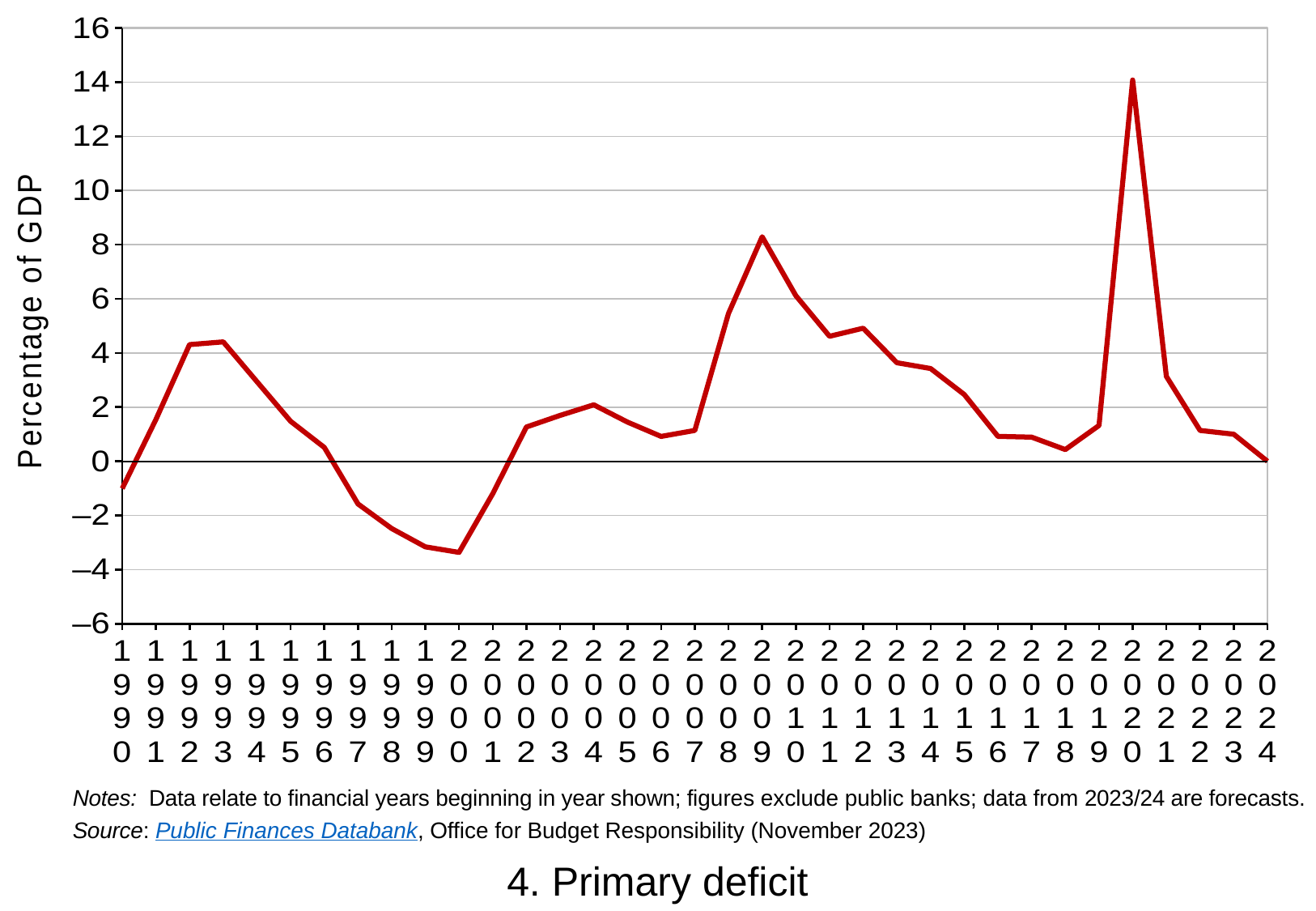
Is the value for 2020 greater or less than 12? greater Which year has the larger primary deficit, 2009 or 2020? 2020 Is the value for 2009 greater or less than 6? greater How many years are plotted along the x axis of the chart? 35 Is the value for 1990 greater or less than 0? less What is the label on the vertical axis of the chart? Percentage of GDP What kind of chart is shown on the slide? line chart In which year is the primary deficit highest? 2020 What is the title of the chart? 4. Primary deficit In which year is the primary deficit lowest? 2000 Between 2009 and 2018, do the values generally rise or fall? fall